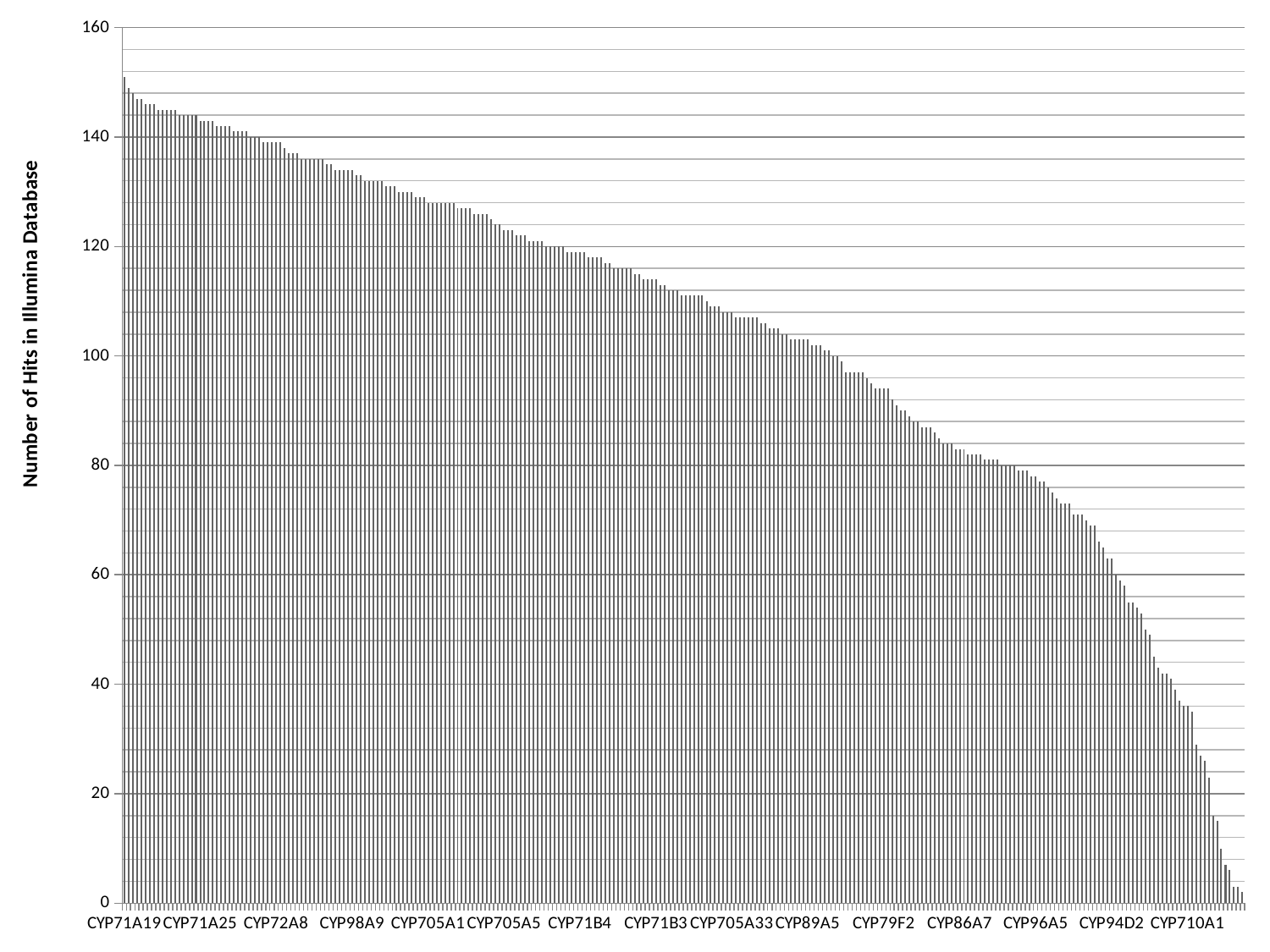
Is the value for CYP705A1 greater or less than 120? greater What is the title of the vertical axis? Number of Hits in Illumina Database Is the value for CYP71A19 greater or less than 140? greater What kind of chart is shown on the slide? bar chart Do the values rise or fall moving from left to right along the x axis? fall Is the value for CYP94D2 greater or less than 80? less Which has the larger value, CYP71A19 or CYP710A1? CYP71A19